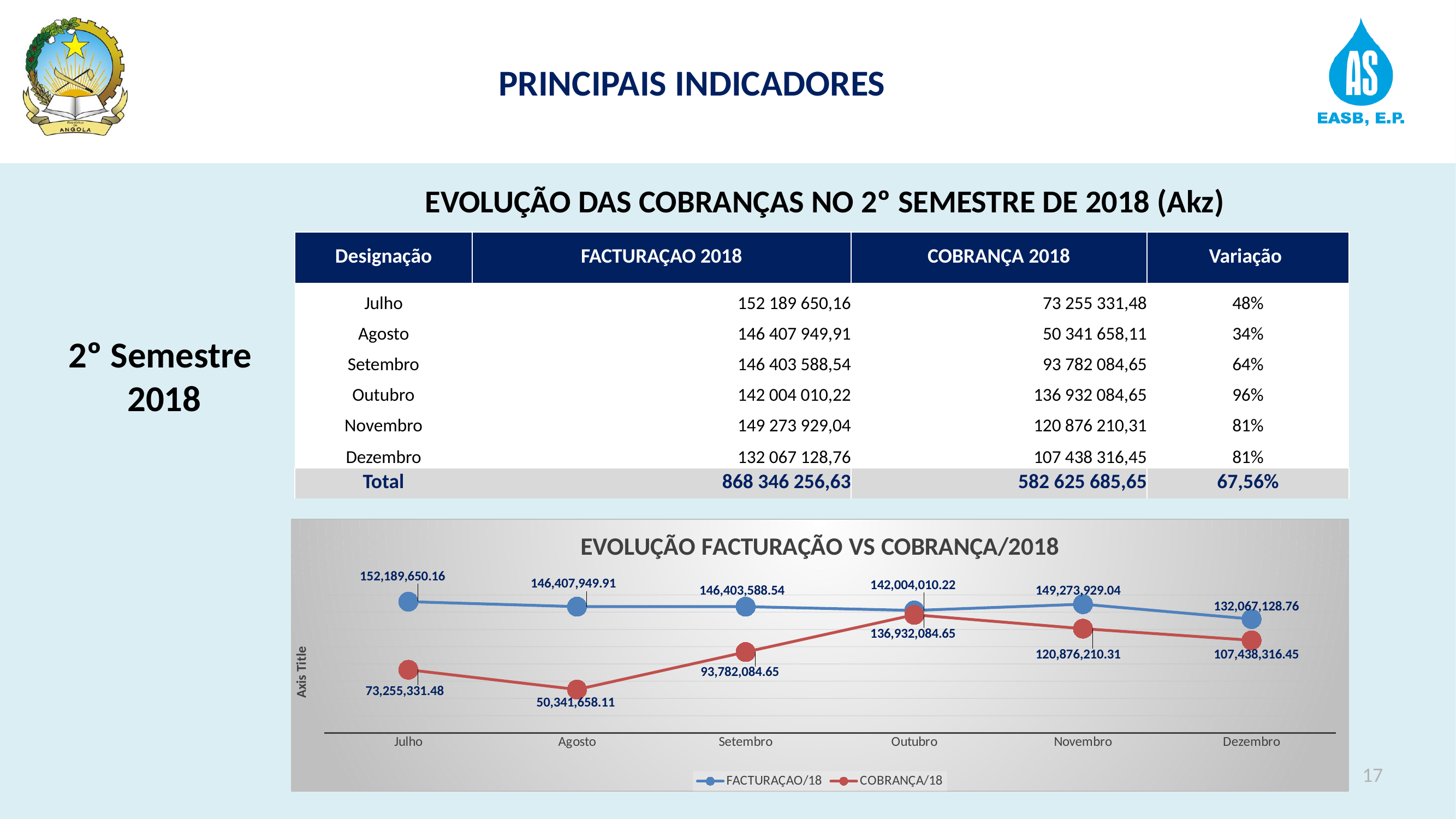
What is the difference between FACTURAÇAO/18 and COBRANÇA/18 in Julho? 78,934,318.68 How many series does the chart legend list? 2 What type of chart is shown on the slide? line chart How many months are plotted along the x axis of the chart? 6 What is the title of the chart? EVOLUÇÃO FACTURAÇÃO VS COBRANÇA/2018 What is the FACTURAÇAO/18 value for Julho in the chart? 152,189,650.16 In which month is the COBRANÇA/18 series highest? Outubro In which month is the COBRANÇA/18 series lowest? Agosto In Outubro, which series has the larger value, FACTURAÇAO/18 or COBRANÇA/18? FACTURAÇAO/18 What is the COBRANÇA/18 value for Agosto in the chart? 50,341,658.11 In which month is the FACTURAÇAO/18 series lowest? Dezembro Does the COBRANÇA/18 series rise or fall from Agosto to Outubro? rise